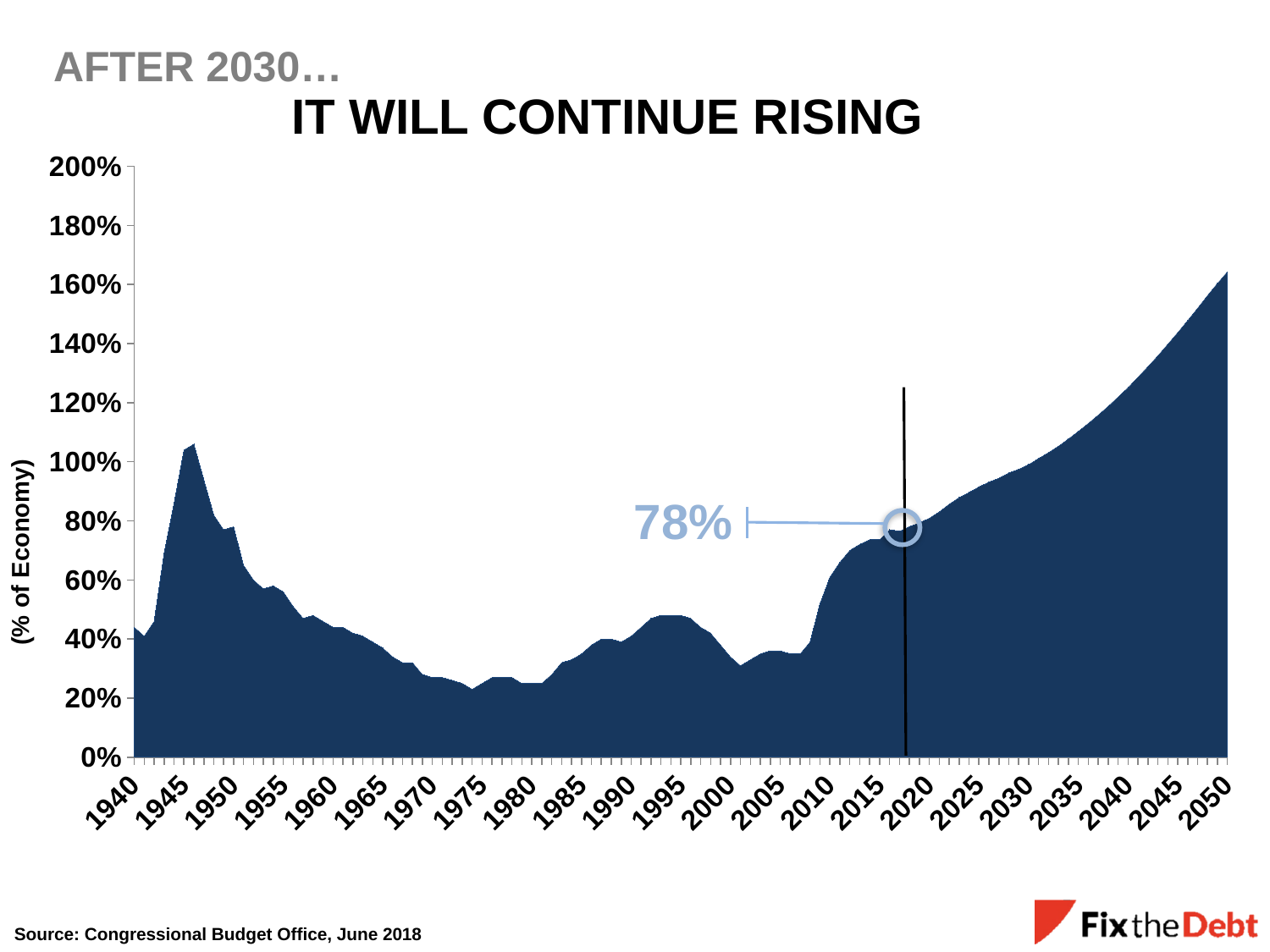
Is the value for 1975 greater or less than 40%? less What value is labeled at the circled point on the chart, around 2018? 78% Do the values rise or fall between the mid-1940s peak and 1975? fall Is the value for 2000 greater or less than 60%? less Which is larger, the value for 2050 or the value for 1990? 2050 What source is cited for the chart? Congressional Budget Office, June 2018 Do the values rise or fall between 2020 and 2050? rise What kind of chart is shown on the slide? area chart Is the peak value in the mid-1940s greater or less than 80%? greater What is the label on the vertical axis? (% of Economy) How many year labels are shown on the x axis? 23